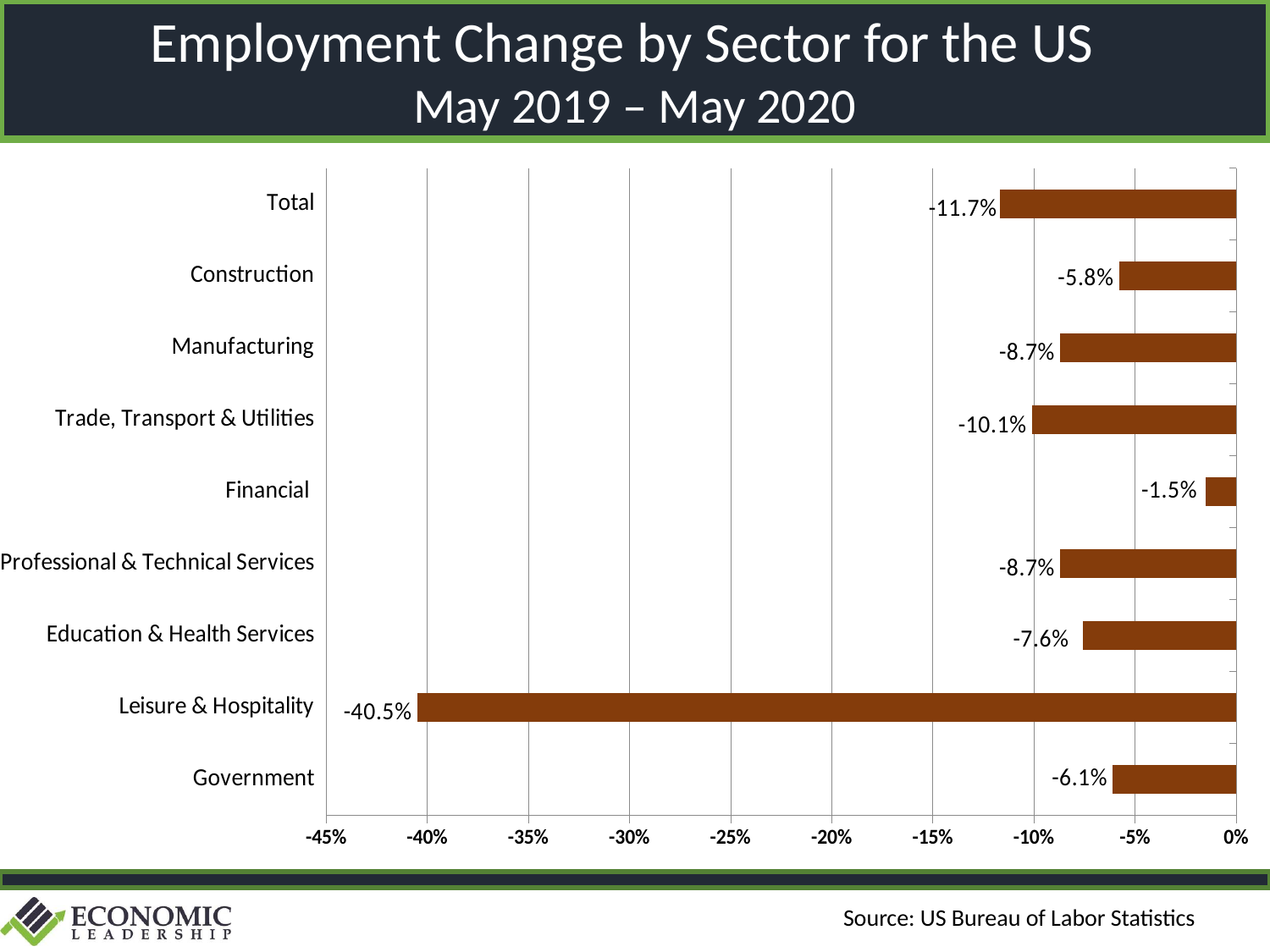
What is the difference between the employment change for Leisure & Hospitality and Government? 34.4 percentage points How many categories are plotted on the chart? 9 What is the source cited for the chart data? US Bureau of Labor Statistics Which sector shows the largest employment decline? Leisure & Hospitality What is the employment change for Construction? -5.8% What is the employment change for Leisure & Hospitality? -40.5% What is the Total employment change shown on the chart? -11.7% Which two sectors both show an employment change of -8.7%? Manufacturing and Professional & Technical Services What kind of chart is shown on the slide? Bar chart Which sector had a larger employment decline, Manufacturing or Education & Health Services? Manufacturing Which sector shows the smallest employment decline? Financial What is the employment change for Trade, Transport & Utilities? -10.1%